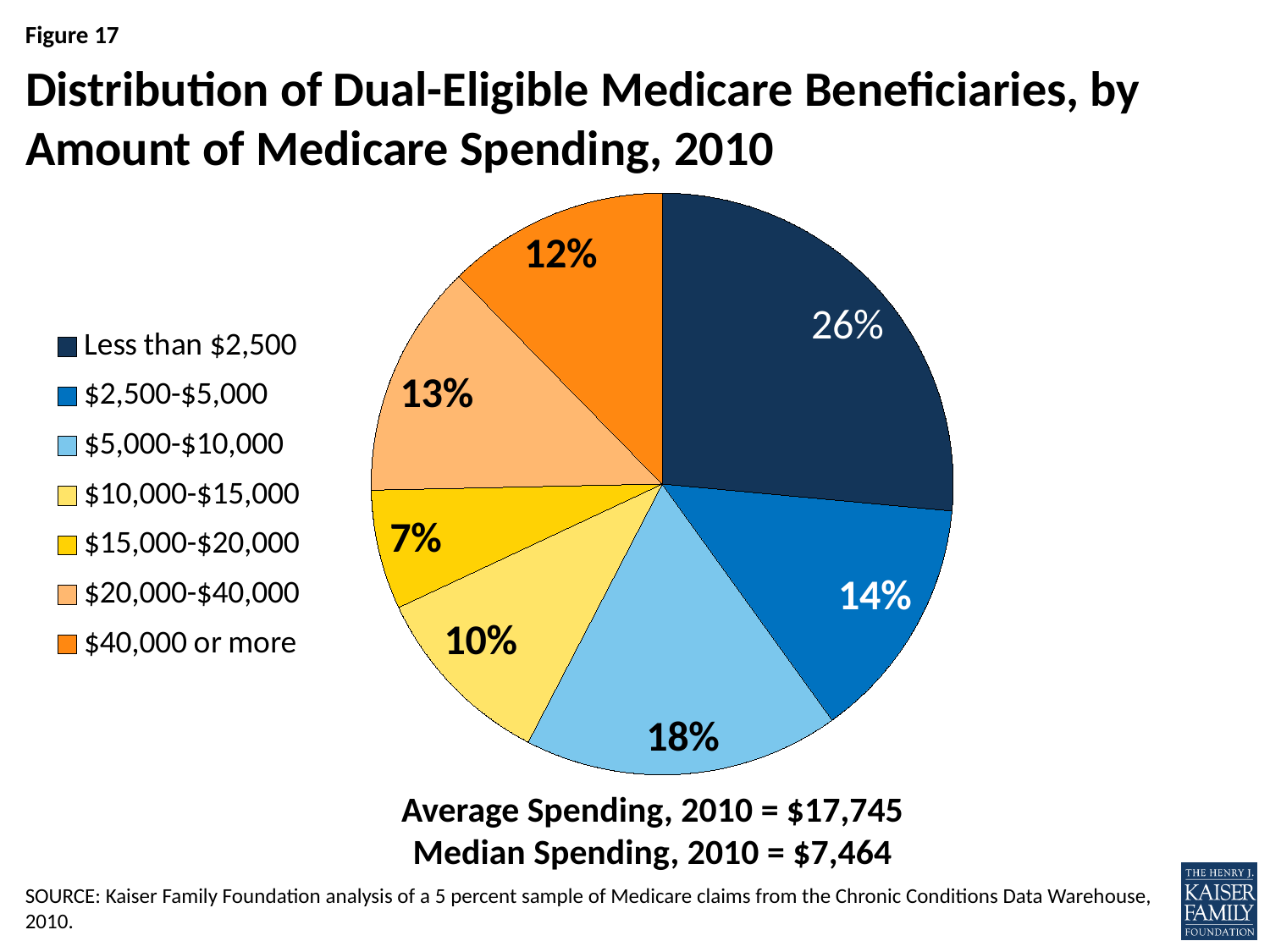
Which category has a larger share: $20,000-$40,000 or $40,000 or more? $20,000-$40,000 What share of dual-eligible Medicare beneficiaries had Medicare spending of less than $2,500? 26% What was the median Medicare spending in 2010 shown below the chart? $7,464 How many spending categories are shown in the pie chart? 7 What was the average Medicare spending in 2010 shown below the chart? $17,745 What is the difference in percentage points between the $2,500-$5,000 and $10,000-$15,000 categories? 4 Which spending category has the smallest share of beneficiaries? $15,000-$20,000 What share of beneficiaries had spending of $40,000 or more? 12% Which spending category has the largest share of beneficiaries? Less than $2,500 What share of beneficiaries fell in the $5,000-$10,000 spending category? 18% What kind of chart is shown on the slide? Pie chart What share of beneficiaries fell in the $15,000-$20,000 spending category? 7%